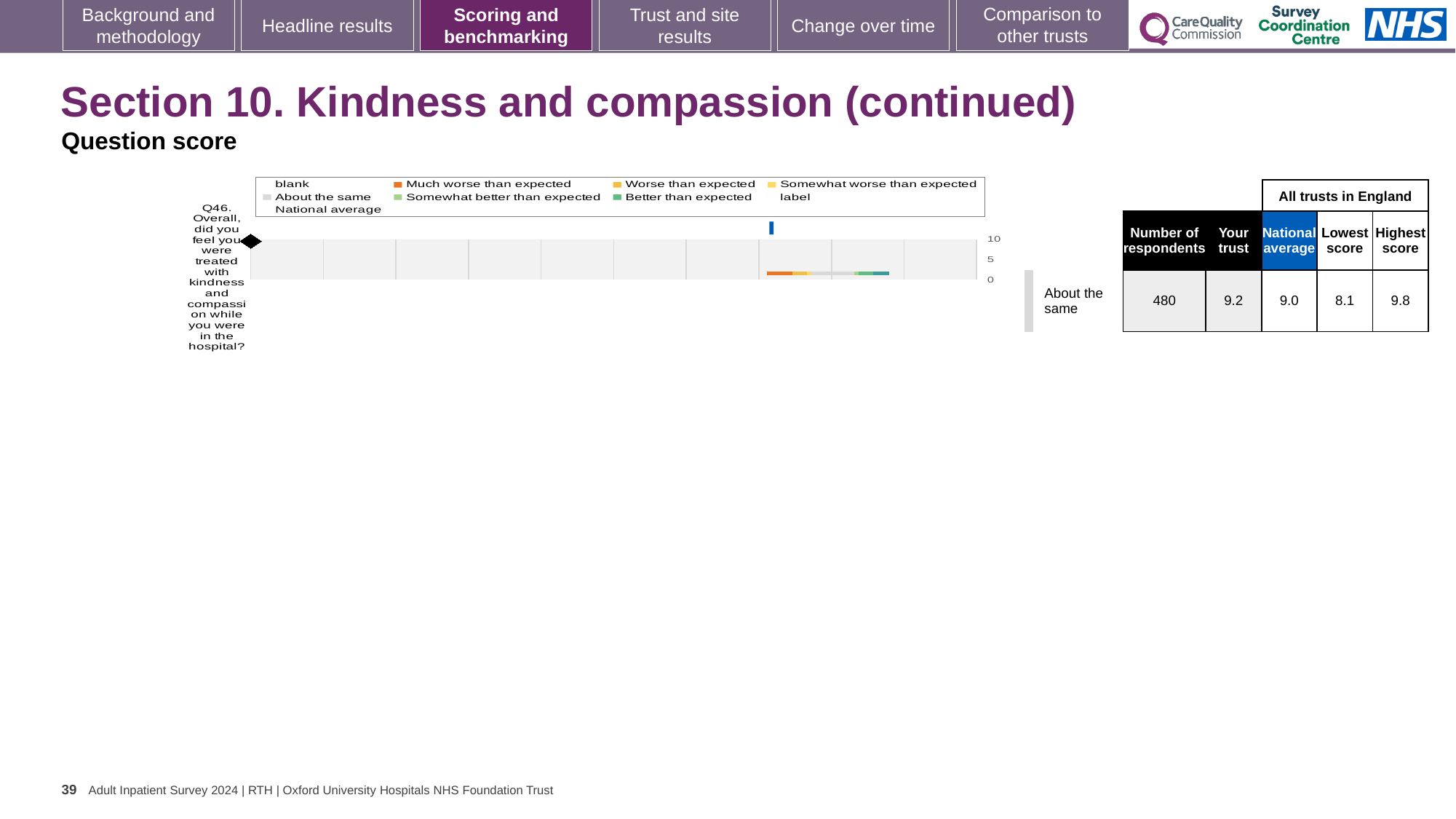
Which is larger for Q46, the Your trust score or the National average? Your trust What kind of chart is shown for Q46? bar chart How many respondents answered Q46? 480 What is the score for Your trust on Q46 (treated with kindness and compassion)? 9.2 What is the National average score for Q46? 9.0 What benchmark category is the trust's Q46 result placed in? About the same What is the difference between the Your trust score and the National average for Q46? 0.2 What is the difference between the Highest score and the Lowest score for Q46? 1.7 What is the maximum value shown on the chart's score axis? 10 What is the Lowest score among all trusts in England for Q46? 8.1 Is the Your trust score for Q46 greater or less than 5? greater What is the Highest score among all trusts in England for Q46? 9.8